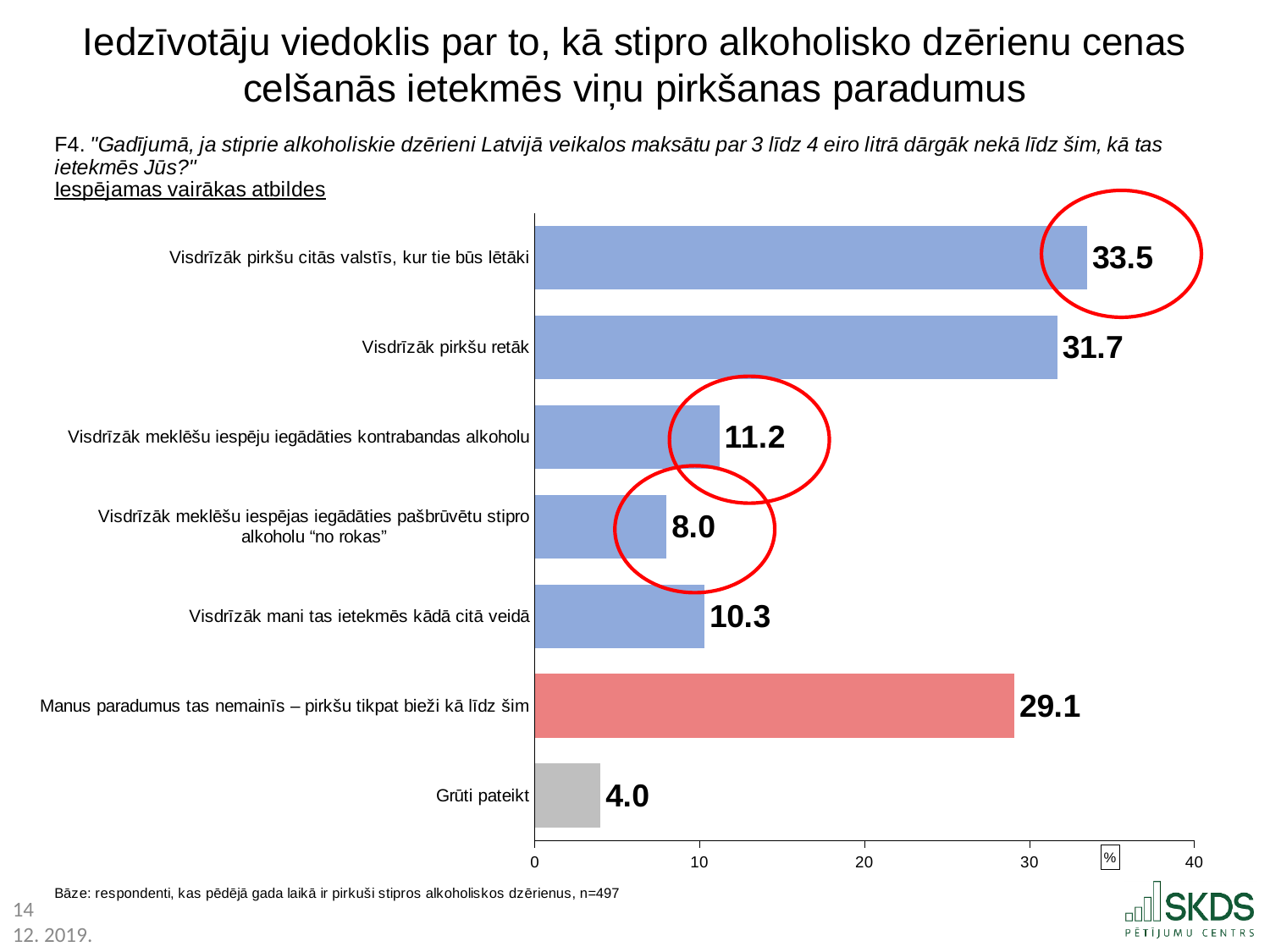
What is the sample size (n) stated in the base note below the chart? 497 Which category has the highest value? Visdrīzāk pirkšu citās valstīs, kur tie būs lētāki What is the value for "Visdrīzāk pirkšu retāk"? 31.7 What is the value for "Visdrīzāk pirkšu citās valstīs, kur tie būs lētāki"? 33.5 Which category has the lowest value? Grūti pateikt Is the value for "Visdrīzāk mani tas ietekmēs kādā citā veidā" greater or less than 20? less What is the value for "Manus paradumus tas nemainīs – pirkšu tikpat bieži kā līdz šim"? 29.1 Which is larger: the value for "Visdrīzāk pirkšu retāk" or for "Manus paradumus tas nemainīs – pirkšu tikpat bieži kā līdz šim"? Visdrīzāk pirkšu retāk What kind of chart is shown on the slide? bar chart What is the difference between the values for "Visdrīzāk meklēšu iespēju iegādāties kontrabandas alkoholu" and "Visdrīzāk meklēšu iespējas iegādāties pašbrūvētu stipro alkoholu “no rokas”"? 3.2 What is the value for "Grūti pateikt"? 4.0 How many categories are shown in the chart? 7